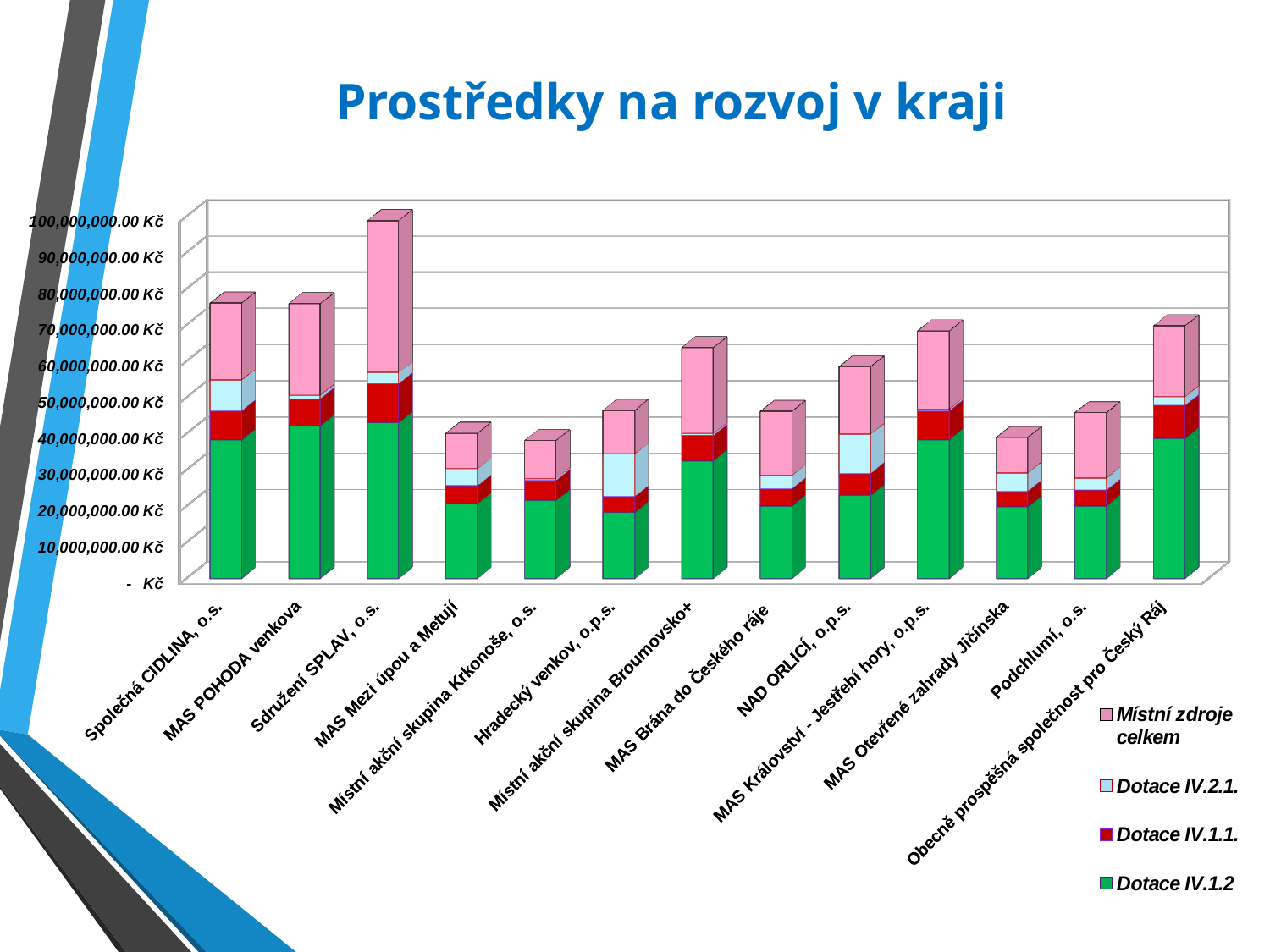
Is the total for MAS Mezi úpou a Metují greater or less than 50,000,000.00 Kč? less Which organisation has the highest total bar? Sdružení SPLAV, o.s. What is the title of the chart? Prostředky na rozvoj v kraji How many series does the legend list? 4 Is the total for NAD ORLICÍ, o.p.s. greater or less than 70,000,000.00 Kč? less Which colour represents the series Dotace IV.1.2 in the legend? Green What kind of chart is shown on the slide? Stacked bar chart Is the total for Obecně prospěšná společnost pro Český Ráj greater or less than 60,000,000.00 Kč? greater Which has the larger total bar: Sdružení SPLAV, o.s. or MAS POHODA venkova? Sdružení SPLAV, o.s. Which has the larger total bar: Místní akční skupina Broumovsko+ or Hradecký venkov, o.p.s.? Místní akční skupina Broumovsko+ How many organisations (categories) are shown on the x axis? 13